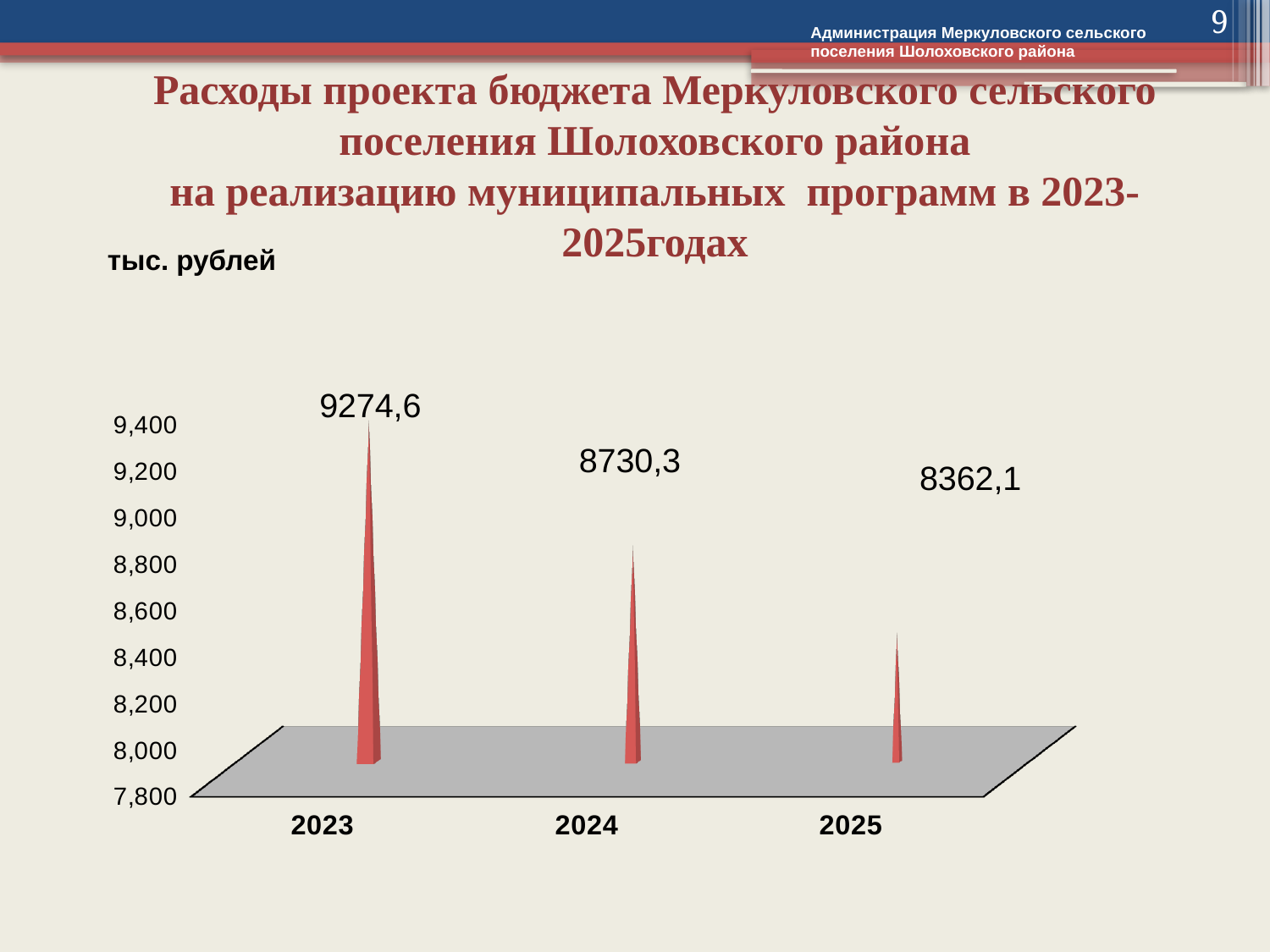
Which year has the lowest value? 2025 How many years are shown on the x axis? 3 Which is larger, the value for 2024 or the value for 2025? 2024 Do the values rise or fall from 2023 to 2025? fall What is the value for 2024? 8730,3 What is the difference between the values for 2024 and 2025? 368,2 What is the difference between the values for 2023 and 2025? 912,5 What is the difference between the values for 2023 and 2024? 544,3 What is the value for 2025? 8362,1 What is the value for 2023? 9274,6 Which year has the highest value? 2023 What kind of chart is shown on the slide? bar chart